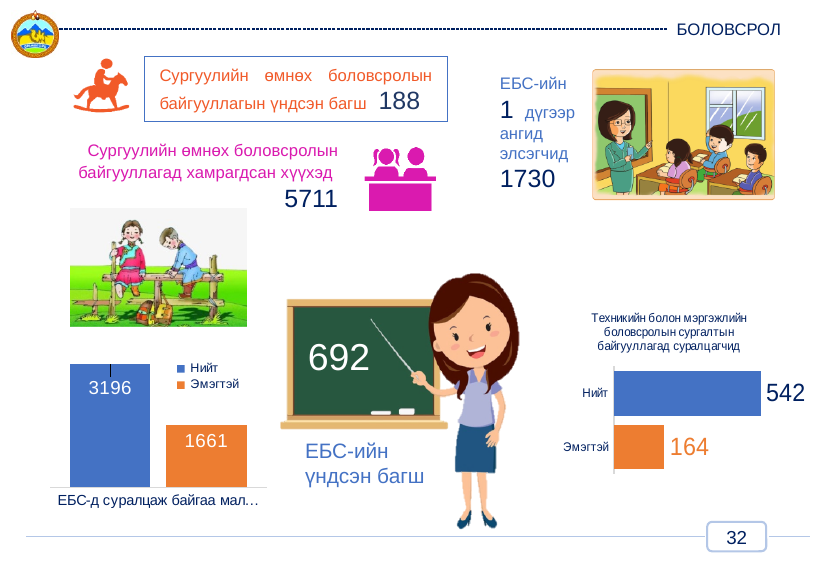
On the bottom-left bar chart, how many entries does the legend list? 2 What type of chart is the bottom-left chart? bar chart On the bottom-right chart titled 'Техникийн болон мэргэжлийн боловсролын сургалтын байгууллагад суралцагчид', what is the value for Нийт? 542 On the bottom-left bar chart, what is the value for Эмэгтэй? 1661 On the bottom-right chart titled 'Техникийн болон мэргэжлийн боловсролын сургалтын байгууллагад суралцагчид', what is the value for Эмэгтэй? 164 On the bottom-left bar chart, what is the difference between Нийт and Эмэгтэй? 1535 On the bottom-left bar chart, which category has the higher value? Нийт On the bottom-right chart, which category has the lower value? Эмэгтэй On the bottom-left bar chart, what is the value for Нийт? 3196 How many bars are shown on the bottom-right chart? 2 On the bottom-right chart, what is the difference between Нийт and Эмэгтэй? 378 On the bottom-right chart, what colour is the bar for Эмэгтэй? orange